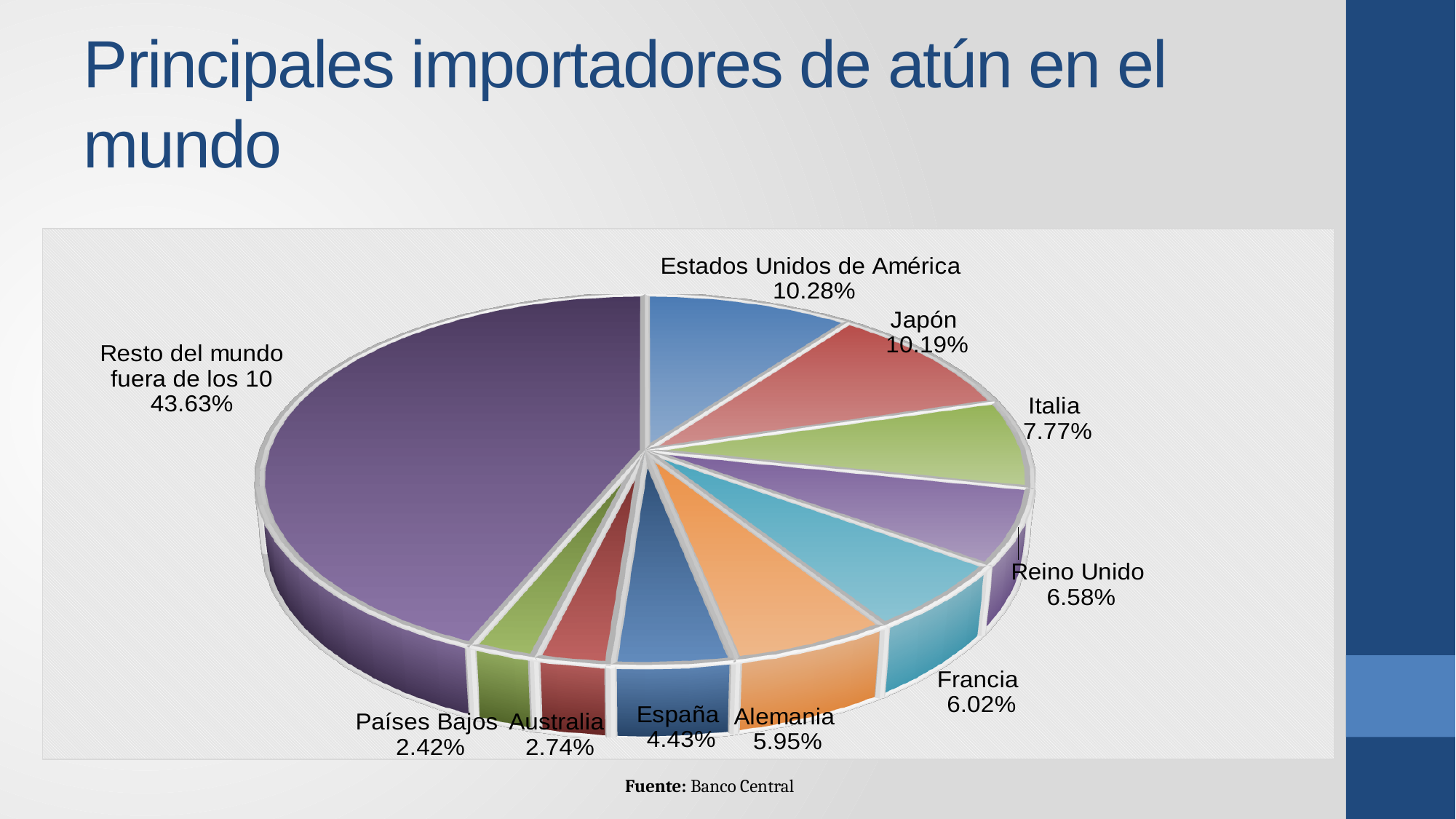
How many slices does the pie chart have? 10 What is the share for Japón? 10.19% What source is cited below the chart? Banco Central What is the title of the slide? Principales importadores de atún en el mundo Which has a larger share, España or Alemania? Alemania Which slice has the largest share? Resto del mundo fuera de los 10 What is the share for Reino Unido? 6.58% What is the share for Estados Unidos de América? 10.28% What is the difference between the shares of Italia and Reino Unido? 1.19% What is the share for Países Bajos? 2.42% What type of chart is shown on the slide? Pie chart Which slice has the smallest share? Países Bajos